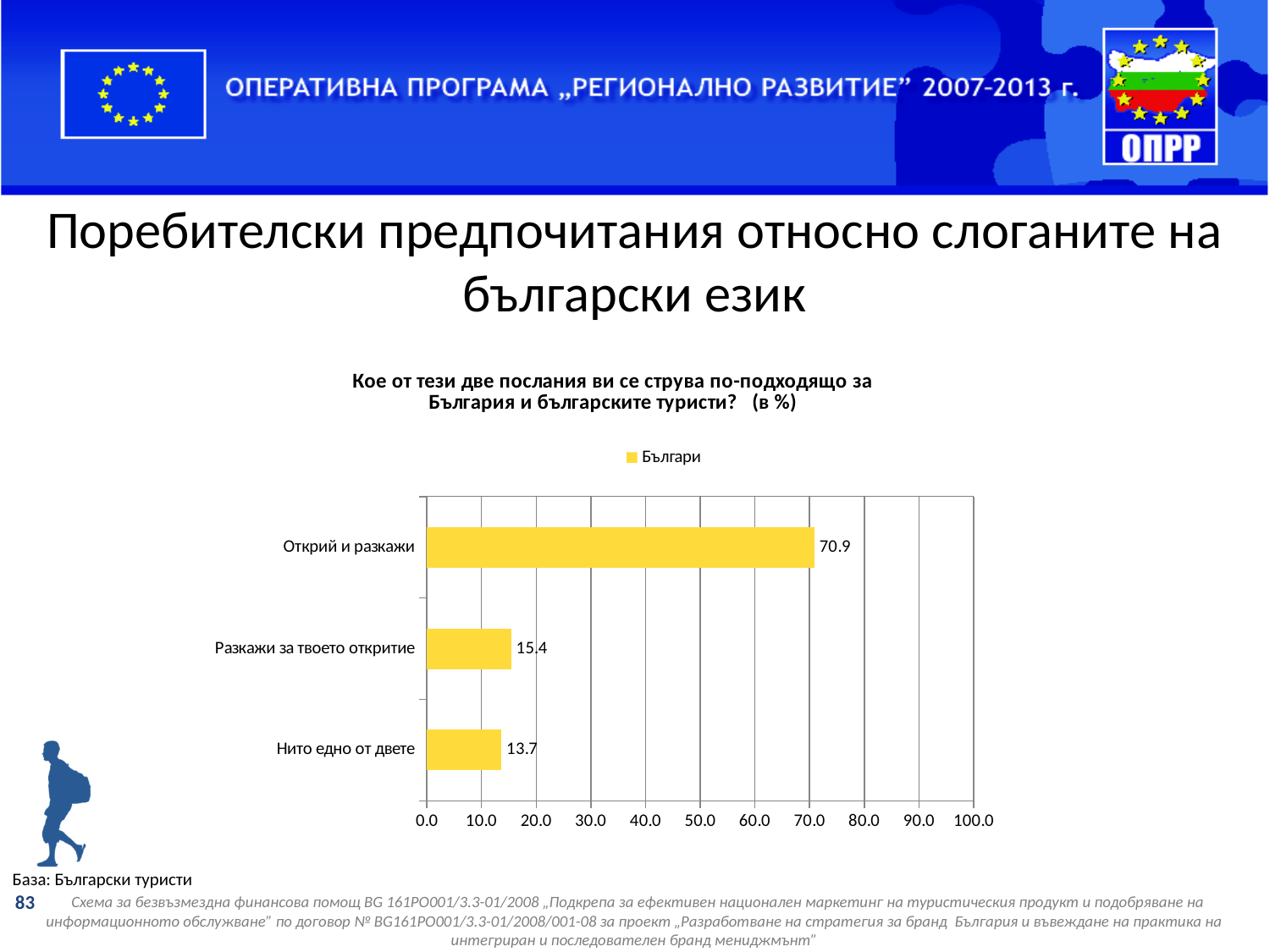
Which category has the lowest value? Нито едно от двете Is the value for "Открий и разкажи" greater or less than 50.0? greater What is the value for "Разкажи за твоето откритие"? 15.4 What is the difference between the values for "Открий и разкажи" and "Разкажи за твоето откритие"? 55.5 How many categories are shown in the chart? 3 What is the difference between the values for "Разкажи за твоето откритие" and "Нито едно от двете"? 1.7 What kind of chart is shown on the slide? bar chart What is the value for "Нито едно от двете"? 13.7 Which category has the highest value? Открий и разкажи Which is larger, the value for "Открий и разкажи" or the value for "Нито едно от двете"? Открий и разкажи What is the value for "Открий и разкажи"? 70.9 What series name does the chart legend show? Българи